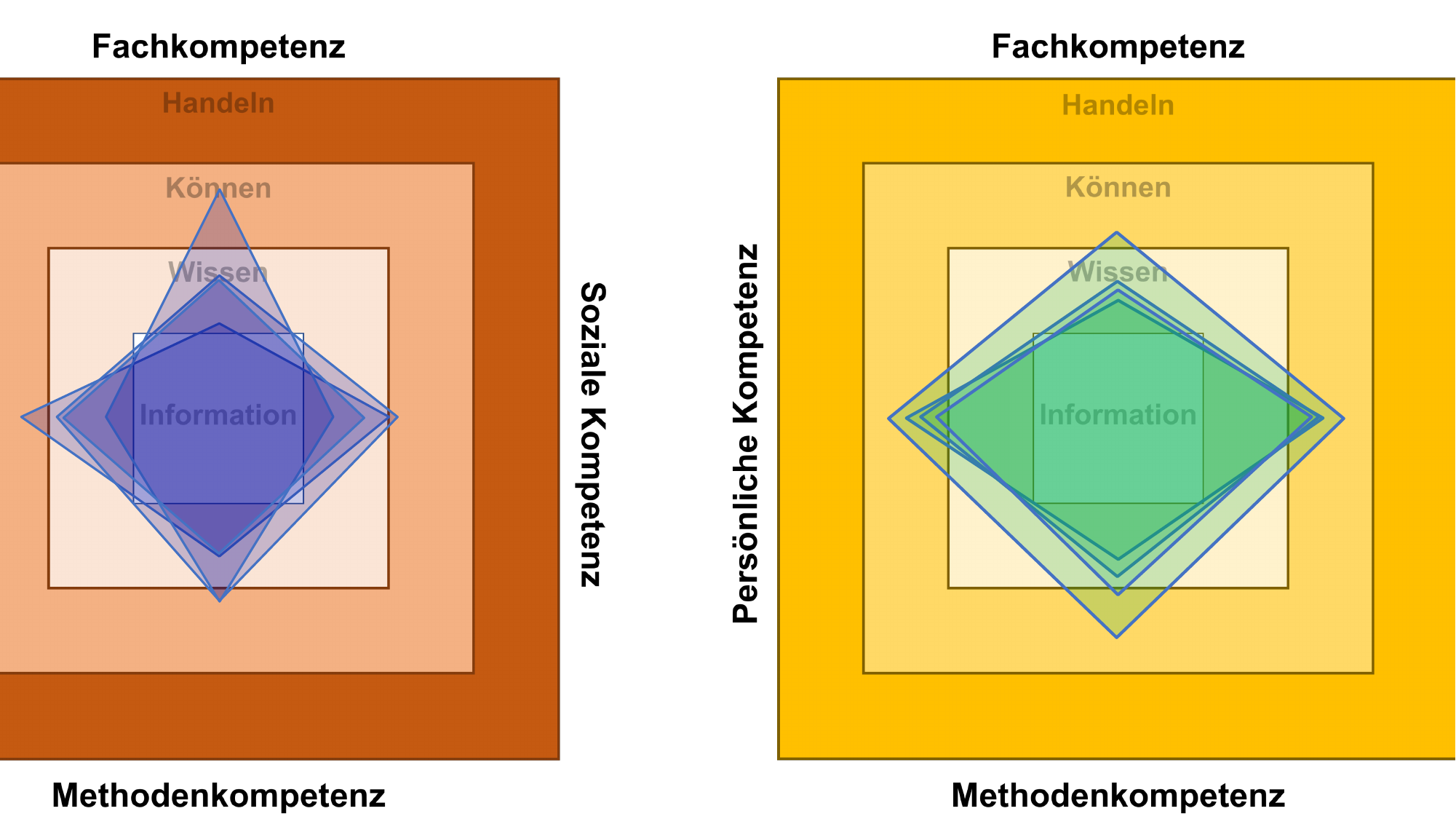
How many nested levels are labelled inside the left diagram? 4 What is the innermost labelled level in the right diagram? Information Which level lies directly inside Können in the right diagram? Wissen How many diagrams are shown on the slide? 2 Which label appears on the vertical axis to the left of the right diagram? Persönliche Kompetenz Which label appears on the vertical axis to the right of the left diagram? Soziale Kompetenz Which level lies directly outside Wissen in the left diagram? Können What is the outermost labelled level in the left diagram? Handeln